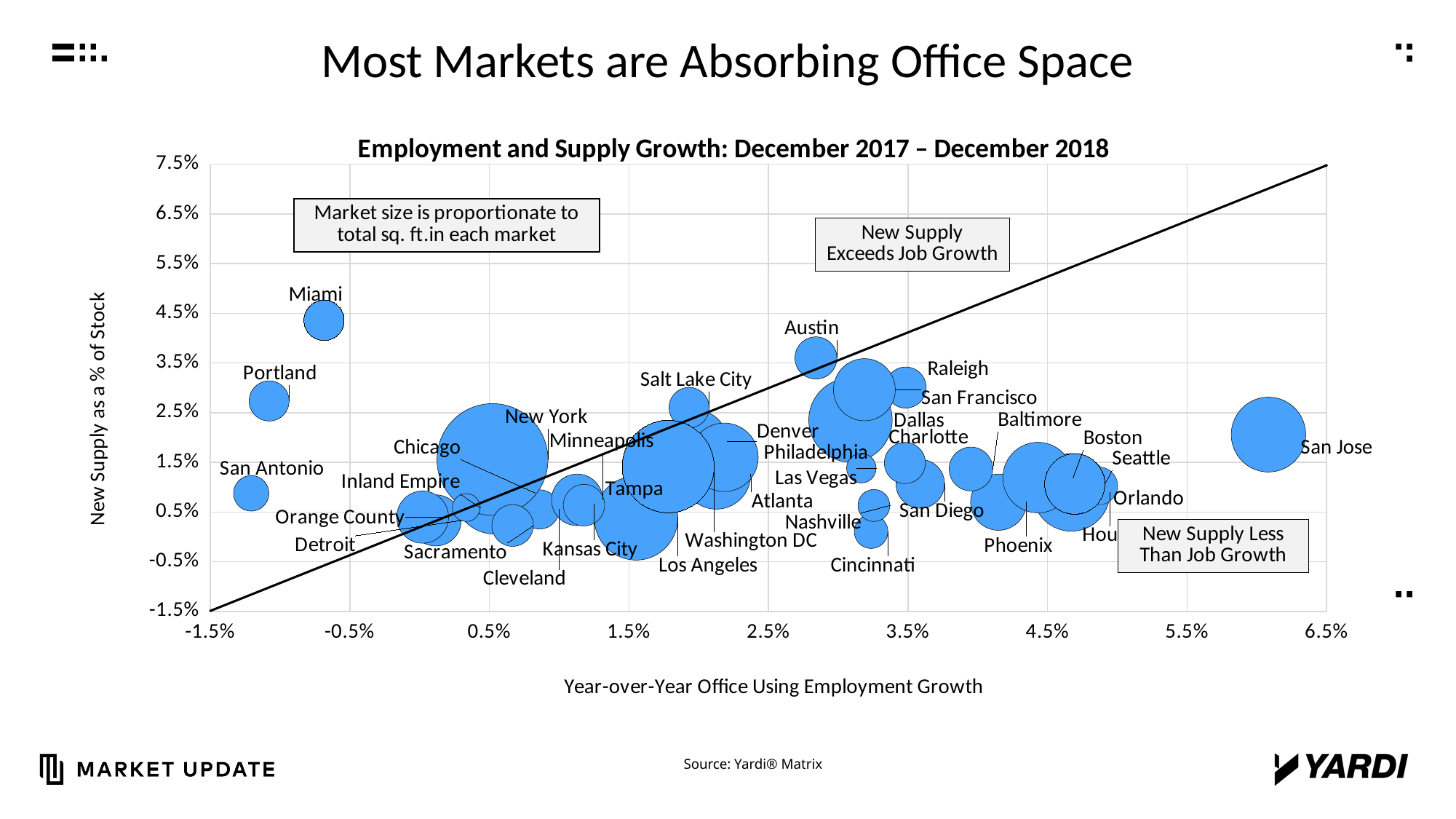
What is the title of the chart? Employment and Supply Growth: December 2017 – December 2018 Which has the higher year-over-year office using employment growth, San Jose or Austin? San Jose Is the new supply as a % of stock for Austin greater or less than 2.5%? greater Is the new supply as a % of stock for Miami greater or less than 3.5%? greater What does the x axis of the chart measure? Year-over-Year Office Using Employment Growth Which market has the highest year-over-year office using employment growth? San Jose What type of chart is shown on the slide? Bubble chart Which has the higher new supply as a % of stock, Miami or Portland? Miami Is the year-over-year office using employment growth for San Jose greater or less than 5.5%? greater Which market has the highest new supply as a % of stock? Miami